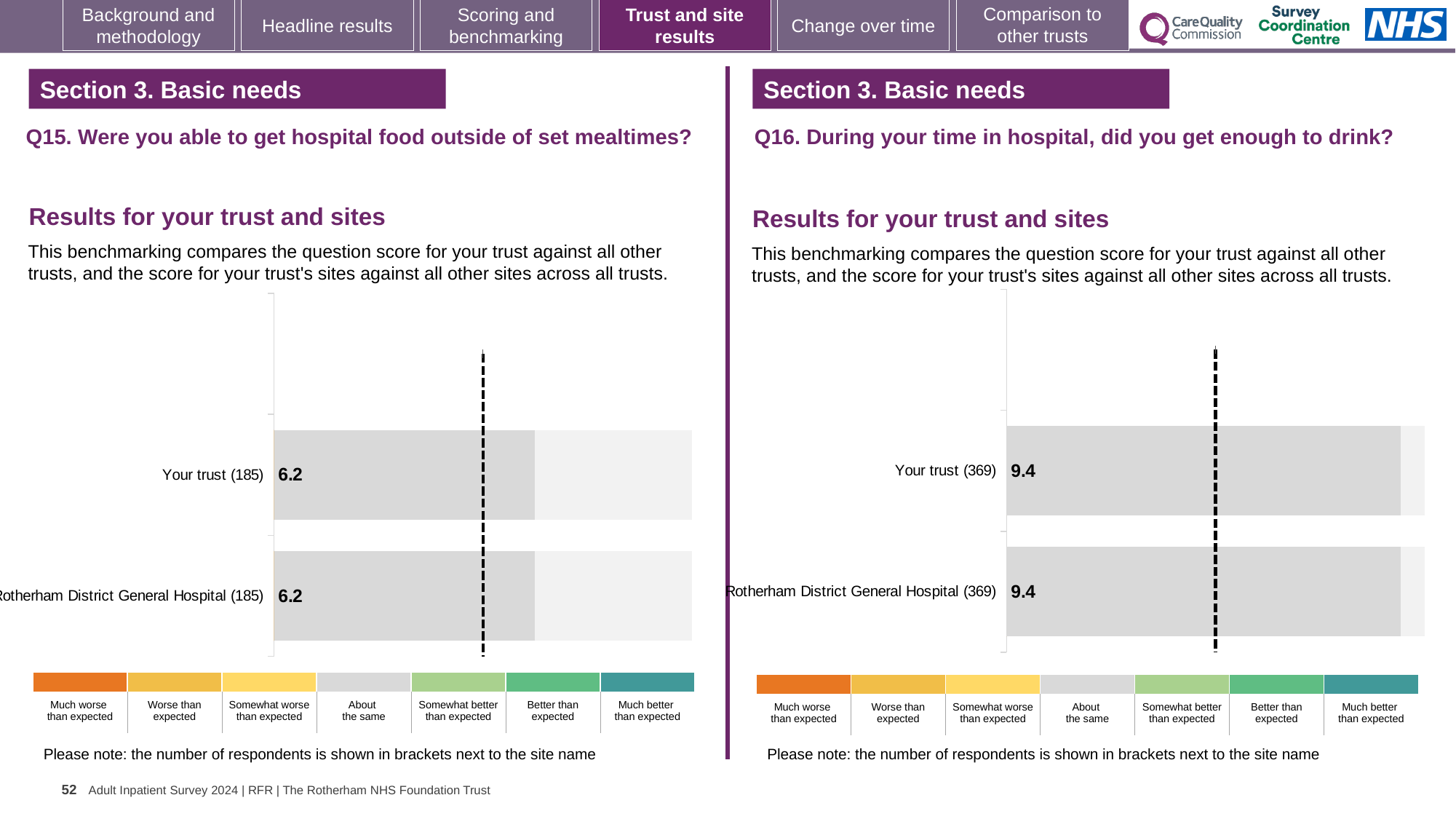
How many bars are plotted in the Q15 chart (left)? 2 In the Q15 chart (left), what is the score for Rotherham District General Hospital? 6.2 What kind of chart is used for the Q15 results (left)? Bar chart In the Q15 chart (left), what is the score for Your trust? 6.2 In the Q15 chart (left), how many respondents are shown in brackets for Your trust? 185 In the Q16 chart (right), what is the difference between the score for Your trust and the score for Rotherham District General Hospital? 0.0 In the Q16 chart (right), what is the score for Rotherham District General Hospital? 9.4 How many bars are plotted in the Q16 chart (right)? 2 Which question does the chart on the right of the slide relate to? Q16. During your time in hospital, did you get enough to drink? In the Q16 chart (right), how many respondents are shown in brackets for Rotherham District General Hospital? 369 In the Q15 chart (left), what is the difference between the score for Your trust and the score for Rotherham District General Hospital? 0.0 In the Q16 chart (right), what is the score for Your trust? 9.4